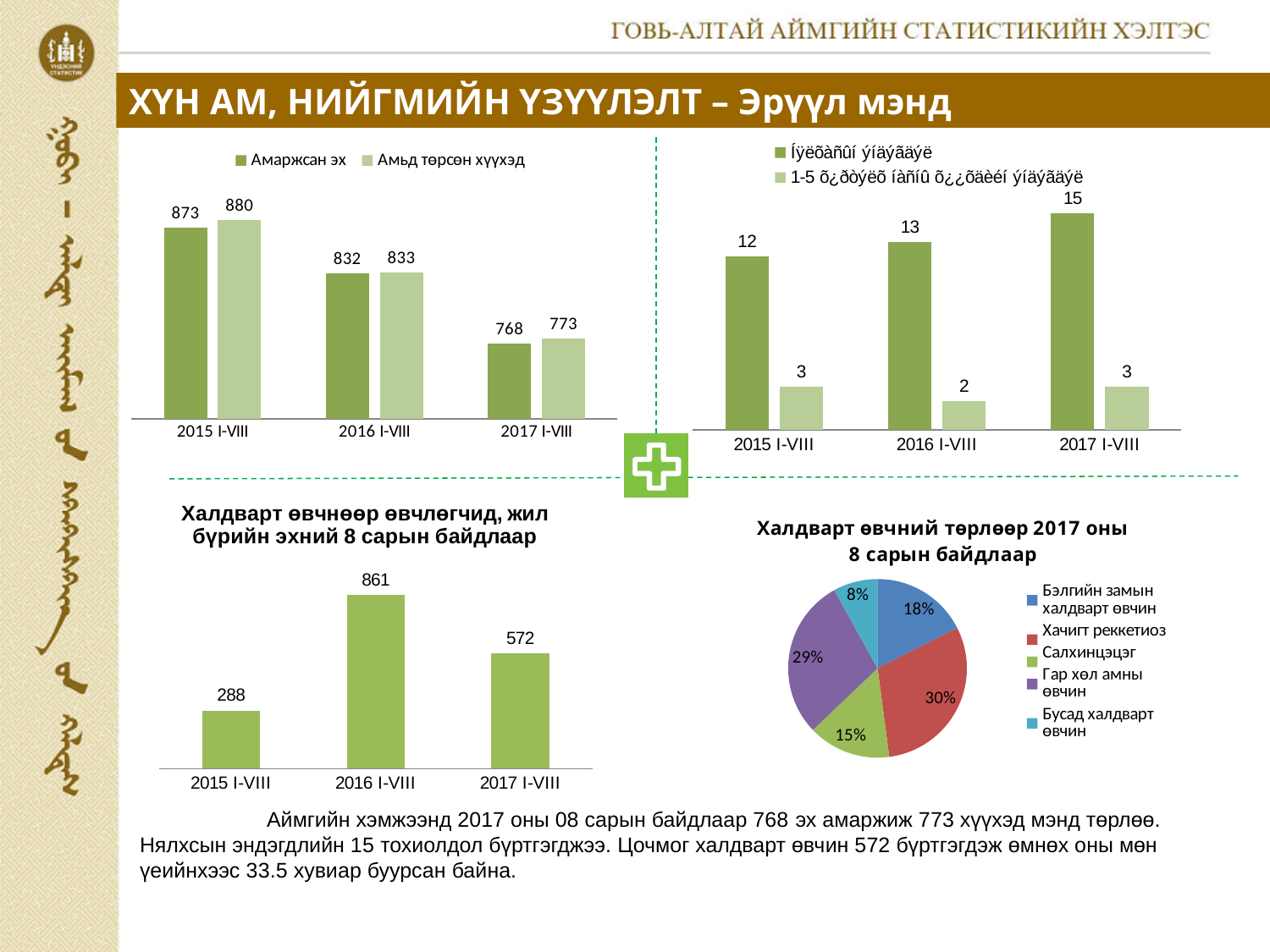
In the top-right bar chart, what is the value of the darker green (first) series for 2017 I-VIII? 15 In the pie chart 'Халдварт өвчний төрлөөр 2017 оны 8 сарын байдлаар', what share does Хачигт реккетиоз have? 30% In the top-left bar chart, what is the value of Амаржсан эх for 2017 I-VIII? 768 In the top-left bar chart, what is the value of Амьд төрсөн хүүхэд for 2015 I-VIII? 880 In the top-left bar chart, does the value of Амаржсан эх rise or fall from 2015 I-VIII to 2017 I-VIII? fall In the chart titled 'Халдварт өвчнөөр өвчлөгчид, жил бүрийн эхний 8 сарын байдлаар', what is the difference between 2016 I-VIII and 2017 I-VIII? 289 In the chart titled 'Халдварт өвчнөөр өвчлөгчид, жил бүрийн эхний 8 сарын байдлаар', which period has the highest value? 2016 I-VIII In the top-right bar chart, which period has the lowest value for the lighter green (second) series? 2016 I-VIII What kind of chart is 'Халдварт өвчний төрлөөр 2017 оны 8 сарын байдлаар'? pie chart In the top-left bar chart, what is the difference between Амьд төрсөн хүүхэд and Амаржсан эх for 2016 I-VIII? 1 How many series does the legend of the top-left bar chart list? 2 In the pie chart 'Халдварт өвчний төрлөөр 2017 оны 8 сарын байдлаар', which category has the smallest share? Бусад халдварт өвчин